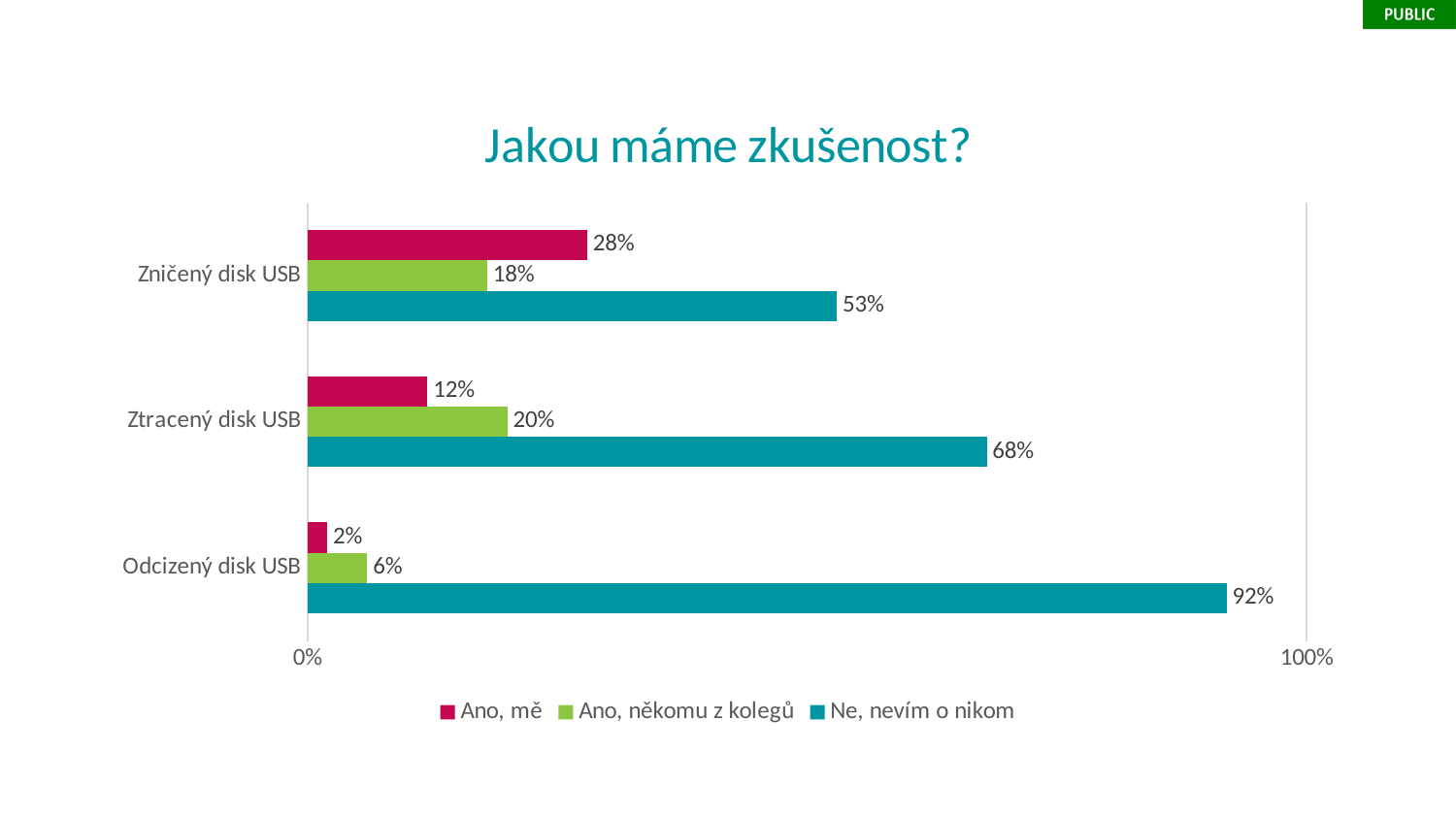
How many series does the legend list? 3 Which is larger for Zničený disk USB: "Ano, mě" or "Ano, někomu z kolegů"? Ano, mě What kind of chart is shown on the slide? Bar chart What is the value for "Ne, nevím o nikom" for Odcizený disk USB? 92% What is the difference between the "Ne, nevím o nikom" values for Ztracený disk USB and Zničený disk USB? 15% Which category has the highest value for "Ne, nevím o nikom"? Odcizený disk USB How many categories are shown on the chart? 3 What is the title of the chart? Jakou máme zkušenost? What is the value for "Ano, někomu z kolegů" for Ztracený disk USB? 20% Which series is shown in green in the legend? Ano, někomu z kolegů Which category has the lowest value for "Ano, mě"? Odcizený disk USB What is the value for "Ano, mě" for Zničený disk USB? 28%